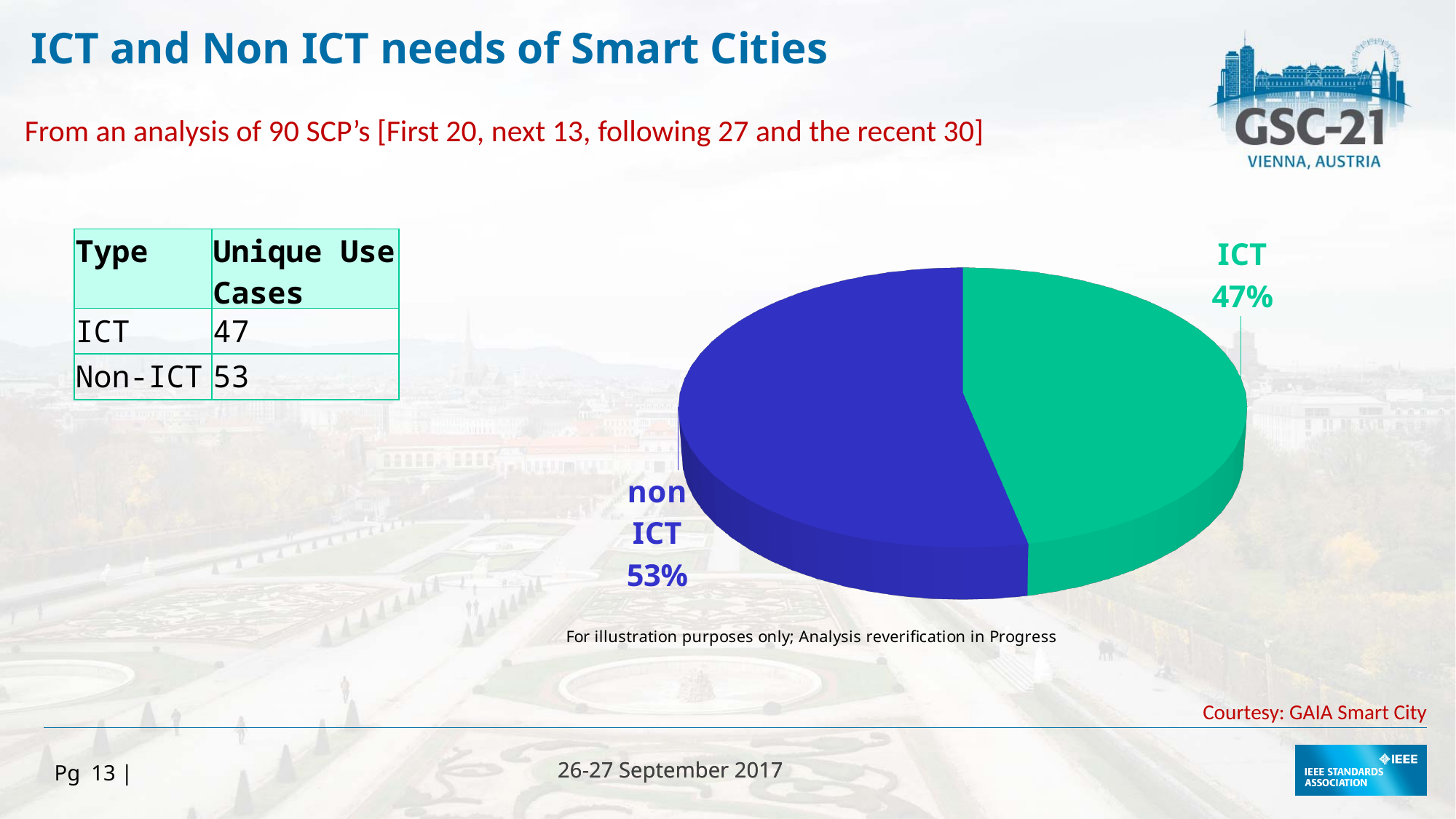
Is the share of the non ICT slice greater or less than 50%? greater What is the difference in percentage points between the non ICT slice and the ICT slice? 6 Which slice of the pie is the smallest? ICT How many slices does the pie chart have? 2 What colour is the non ICT slice of the pie? blue What percentage of the pie does the non ICT slice represent? 53% Which slice of the pie is the largest? non ICT What colour is the ICT slice of the pie? green Which is larger, the ICT slice or the non ICT slice? non ICT What kind of chart is shown on the slide? pie chart What percentage of the pie does the ICT slice represent? 47% Is the share of the ICT slice greater or less than 50%? less